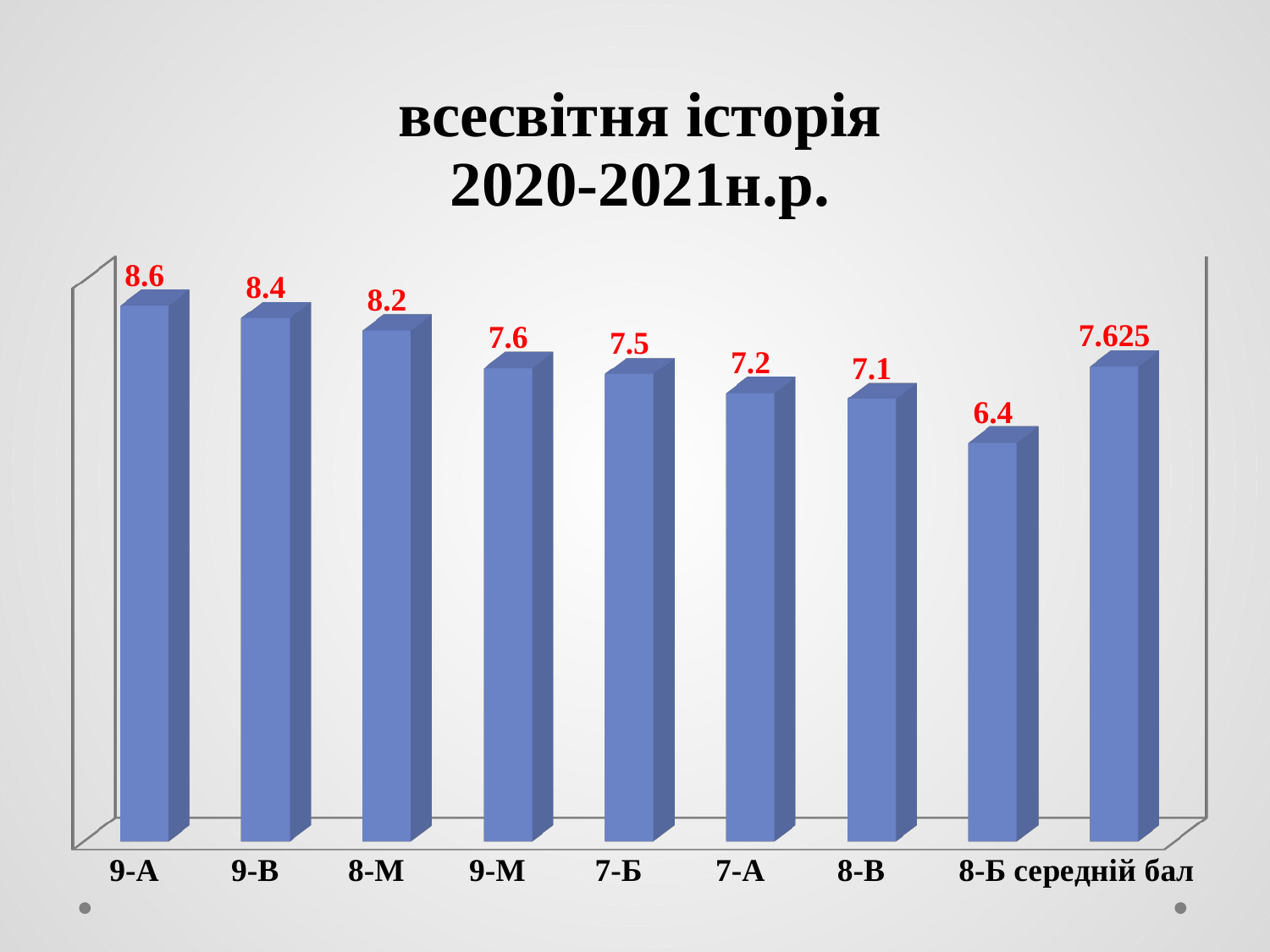
What kind of chart is this? bar chart What is the value for 9-А? 8.6 Which is larger, the value for 8-М or the value for 9-М? 8-М What is the title of the chart? всесвітня історія 2020-2021н.р. What is the value for 7-Б? 7.5 Which category has the highest value? 9-А What is the difference between the values for 9-А and 8-Б? 2.2 Do the values rise or fall from 9-А to 8-Б along the x axis? fall What is the value for середній бал? 7.625 What is the value for 8-Б? 6.4 How many categories are shown on the x axis? 9 Which category has the lowest value? 8-Б